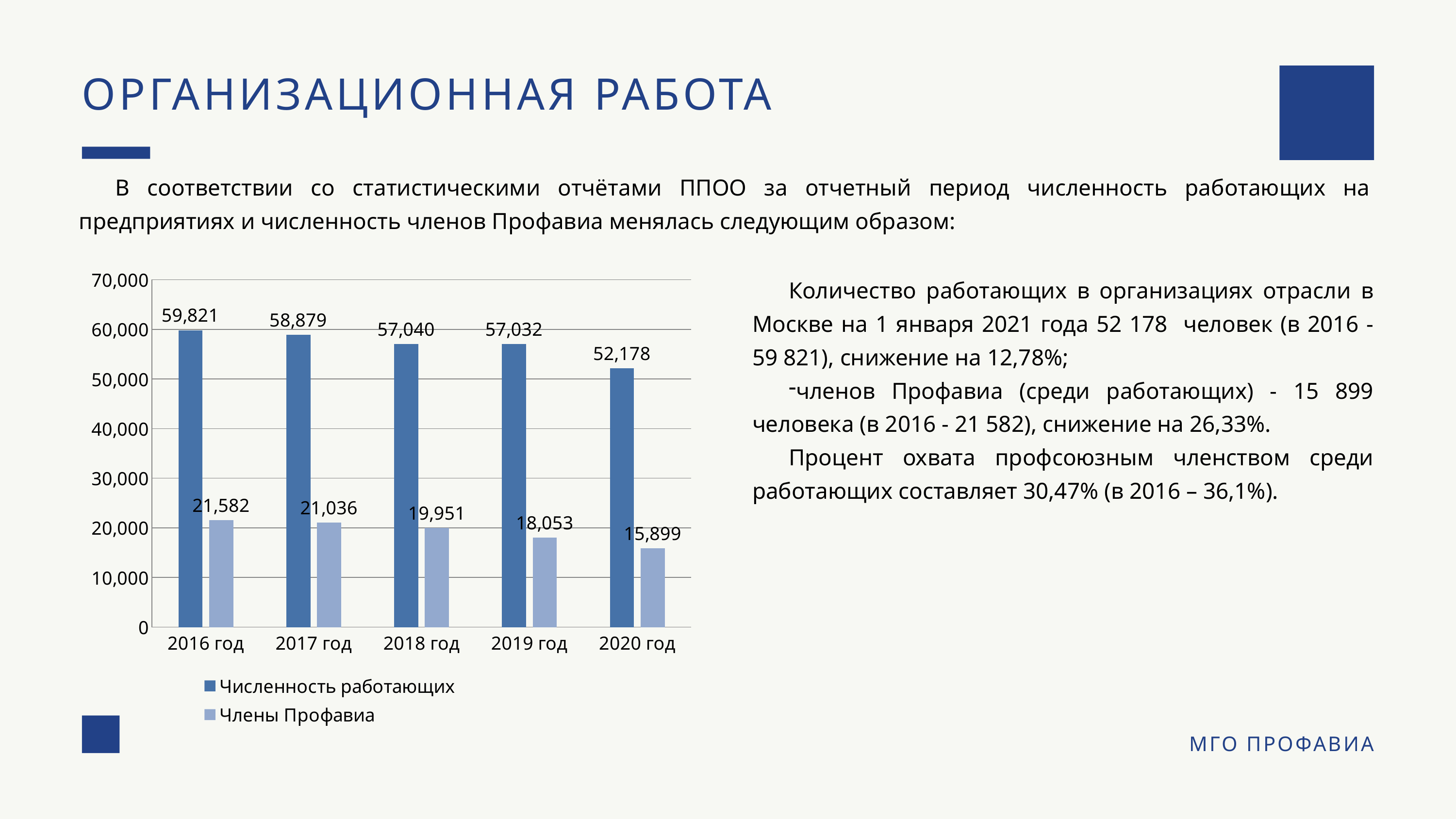
Which is larger: Члены Профавиа in 2019 год or in 2018 год? 2018 год Which year has the lowest value for Члены Профавиа? 2020 год How many years are shown on the x axis of the chart? 5 Is the value of Численность работающих for 2020 год greater or less than 50,000? greater What is the difference between Члены Профавиа in 2016 год and 2017 год? 546 Which year has the highest value for Численность работающих? 2016 год What kind of chart is shown on the slide? Bar chart What is the value of Численность работающих for 2016 год? 59,821 What is the difference between Численность работающих in 2016 год and 2020 год? 7,643 How many series does the chart legend list? 2 What is the value of Члены Профавиа for 2018 год? 19,951 What is the value of Члены Профавиа for 2020 год? 15,899